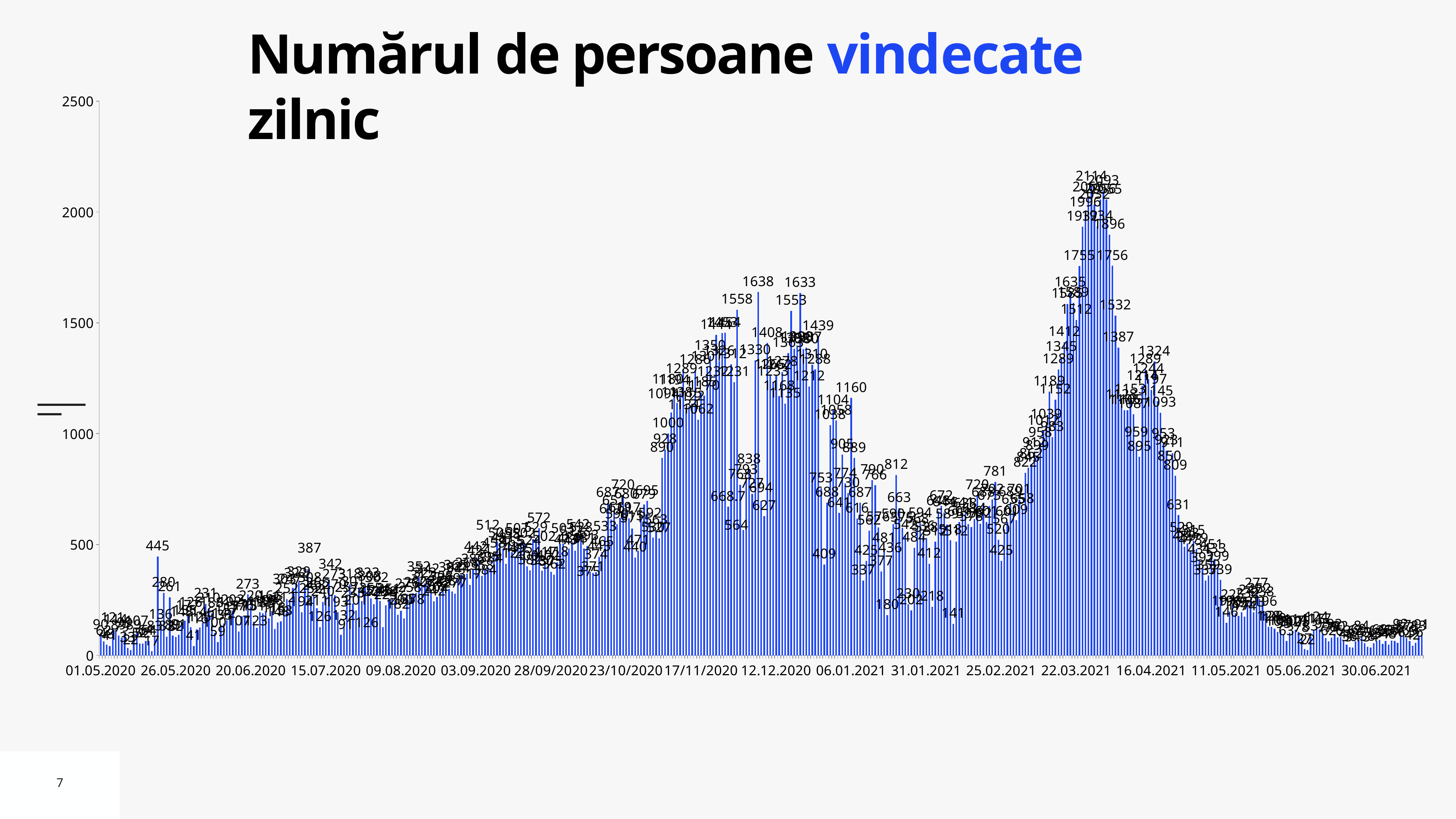
Which is larger, the 1638 label near 12.12.2020 or the 1558 label just before it? 1638 What is the highest value shown on the vertical axis? 2500 Which peak is higher, the one around 12.12.2020 or the one around 22.03.2021? the one around 22.03.2021 What is the value of the tallest bar in the chart? 2114 Are the values around 05.06.2021 greater or less than 500? less Do the values rise or fall from 22.03.2021 to 05.06.2021? fall What kind of chart is shown on the slide? bar chart Do the values rise or fall from 25.02.2021 to 22.03.2021? rise What is the difference between the highest labeled value, 2114, and the 1638 label near 12.12.2020? 476 What is the title of the chart? Numărul de persoane vindecate zilnic Is the tallest bar in the chart greater or less than 2000? greater Are the values around 01.05.2020 greater or less than 500? less